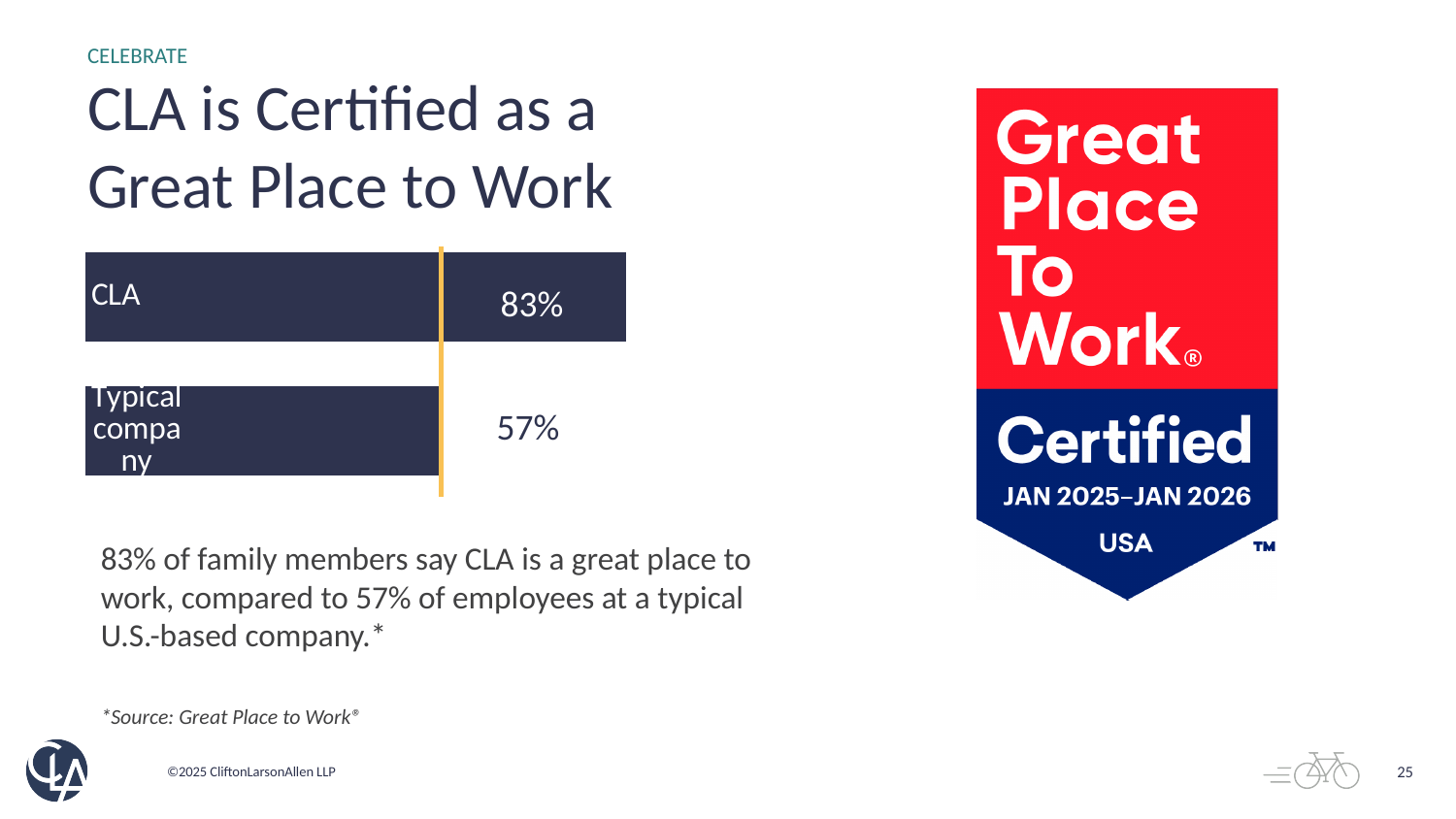
Which category has the highest value in the bar chart? CLA Which category has the lowest value in the bar chart? Typical company How many categories are shown in the bar chart? 2 Which is larger, the value for CLA or the value for Typical company? CLA What value is shown for CLA in the bar chart? 83% What value is shown for Typical company in the bar chart? 57% What is the difference between the CLA value and the Typical company value? 26% What kind of chart is shown on the slide? Bar chart What colour are the bars in the chart? Dark navy blue Are the bars in the chart horizontal or vertical? Horizontal